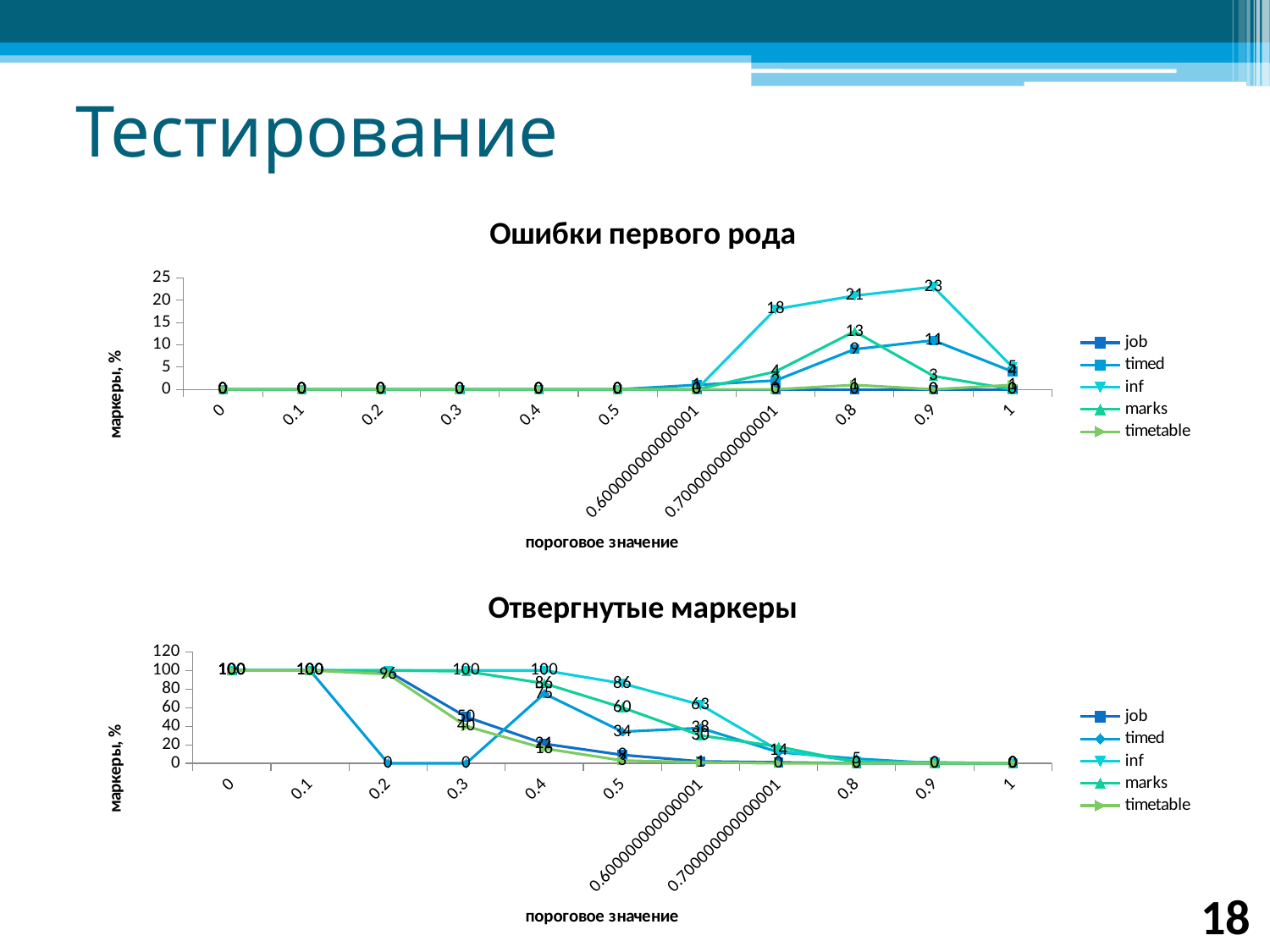
In the top chart "Ошибки первого рода", what is the value of the job series at threshold 0.9? 0 In the top chart "Ошибки первого рода", which series reaches the highest value? inf How many series does the legend of the bottom chart "Отвергнутые маркеры" list? 5 In the bottom chart "Отвергнутые маркеры", do the values generally rise or fall as the threshold increases from 0 to 1? fall In the bottom chart "Отвергнутые маркеры", what is the value of the inf series at threshold 0.6000000000000001? 63 In the top chart "Ошибки первого рода", at threshold 0.9, which is larger: the inf value or the job value? inf In the bottom chart "Отвергнутые маркеры", what is the value of the timed series at threshold 0.2? 0 In the top chart "Ошибки первого рода", what is the value of the inf series at threshold 0.9? 23 How many x-axis categories (threshold values) are plotted in the top chart "Ошибки первого рода"? 11 In the top chart "Ошибки первого рода", what is the value of the inf series at threshold 0.7000000000000001? 18 What kind of chart is the top chart titled "Ошибки первого рода"? line chart In the top chart "Ошибки первого рода", what is the difference between the inf values at 0.9 and at 0.7000000000000001? 5